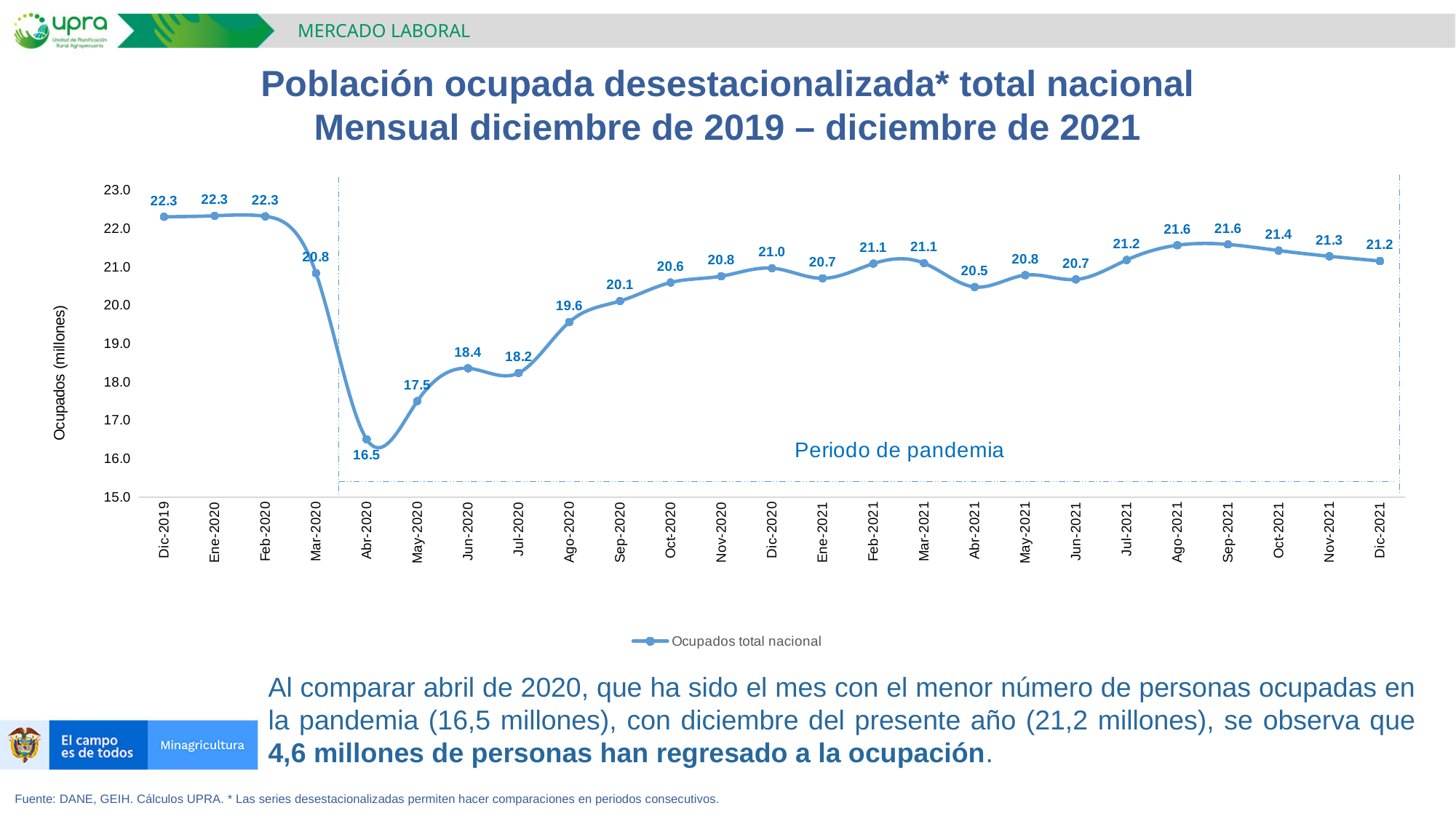
How many data points are plotted on the chart? 25 What is the value for Abr-2020? 16.5 What is the label of the y axis? Ocupados (millones) Is the value for May-2020 greater or less than 18.0? less What is the value for Ago-2021? 21.6 What is the value for Mar-2020? 20.8 What is the value for Dic-2021? 21.2 What kind of chart is shown on the slide? line chart What is the difference between the values for Dic-2019 and Mar-2020? 1.5 What is the difference between the values for Dic-2021 and Abr-2020? 4.7 Which is larger, the value for Jun-2020 or the value for Jul-2020? Jun-2020 Which month has the lowest value? Abr-2020